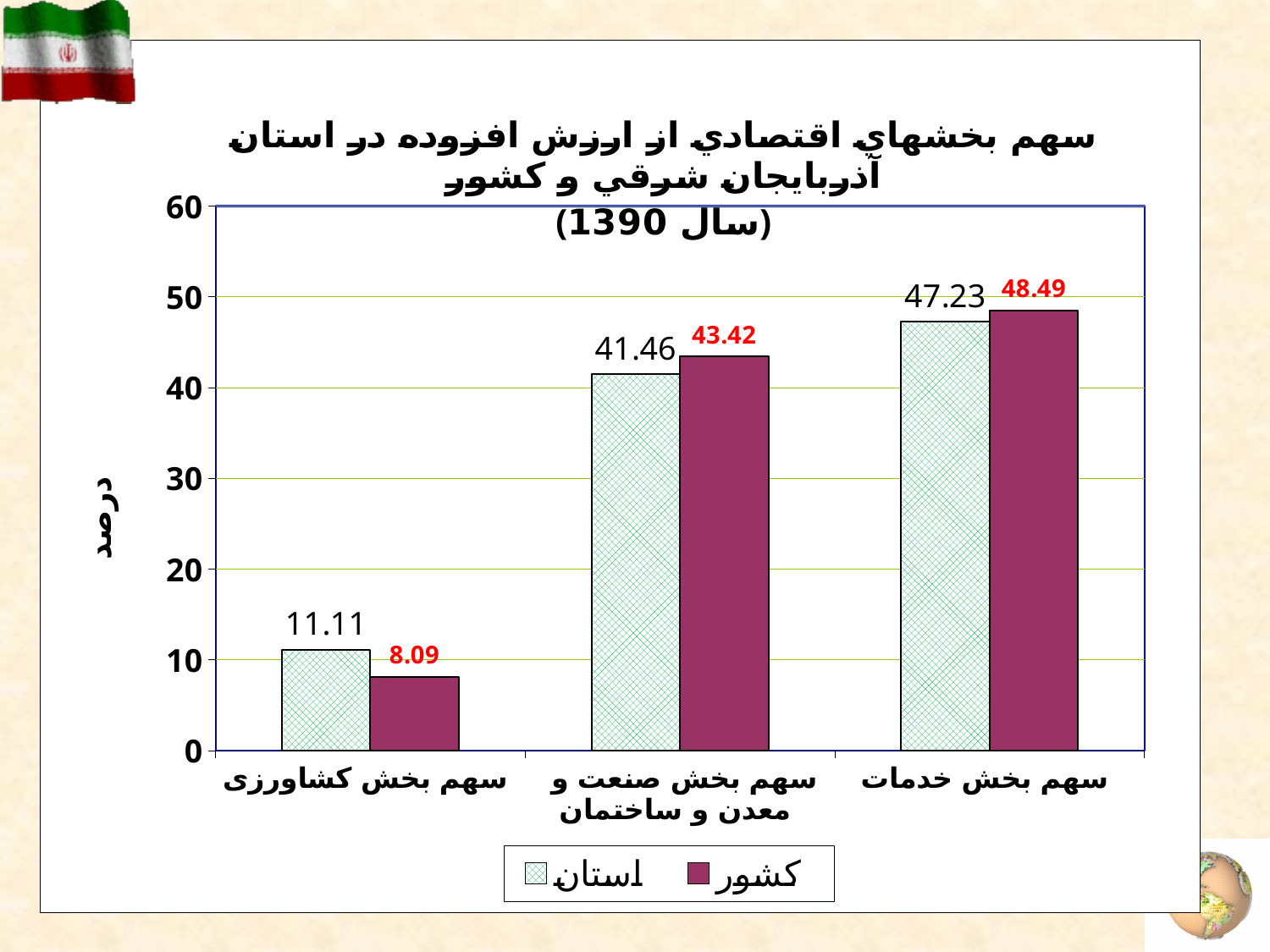
What kind of chart is shown on the slide? bar chart Which category has the lowest value for کشور? سهم بخش کشاورزی How many categories are shown on the x axis? 3 What is the difference between the استان and کشور values in the سهم بخش کشاورزی category? 3.02 What is the label on the vertical axis? درصد Which category has the highest value for استان? سهم بخش خدمات How many series does the legend list? 2 Is the value for استان in the سهم بخش خدمات category greater or less than 40? greater What is the value for کشور in the سهم بخش صنعت و معدن و ساختمان category? 43.42 In the سهم بخش صنعت و معدن و ساختمان category, which series has the larger value, استان or کشور? کشور What is the value for استان in the سهم بخش کشاورزی category? 11.11 What is the value for کشور in the سهم بخش خدمات category? 48.49